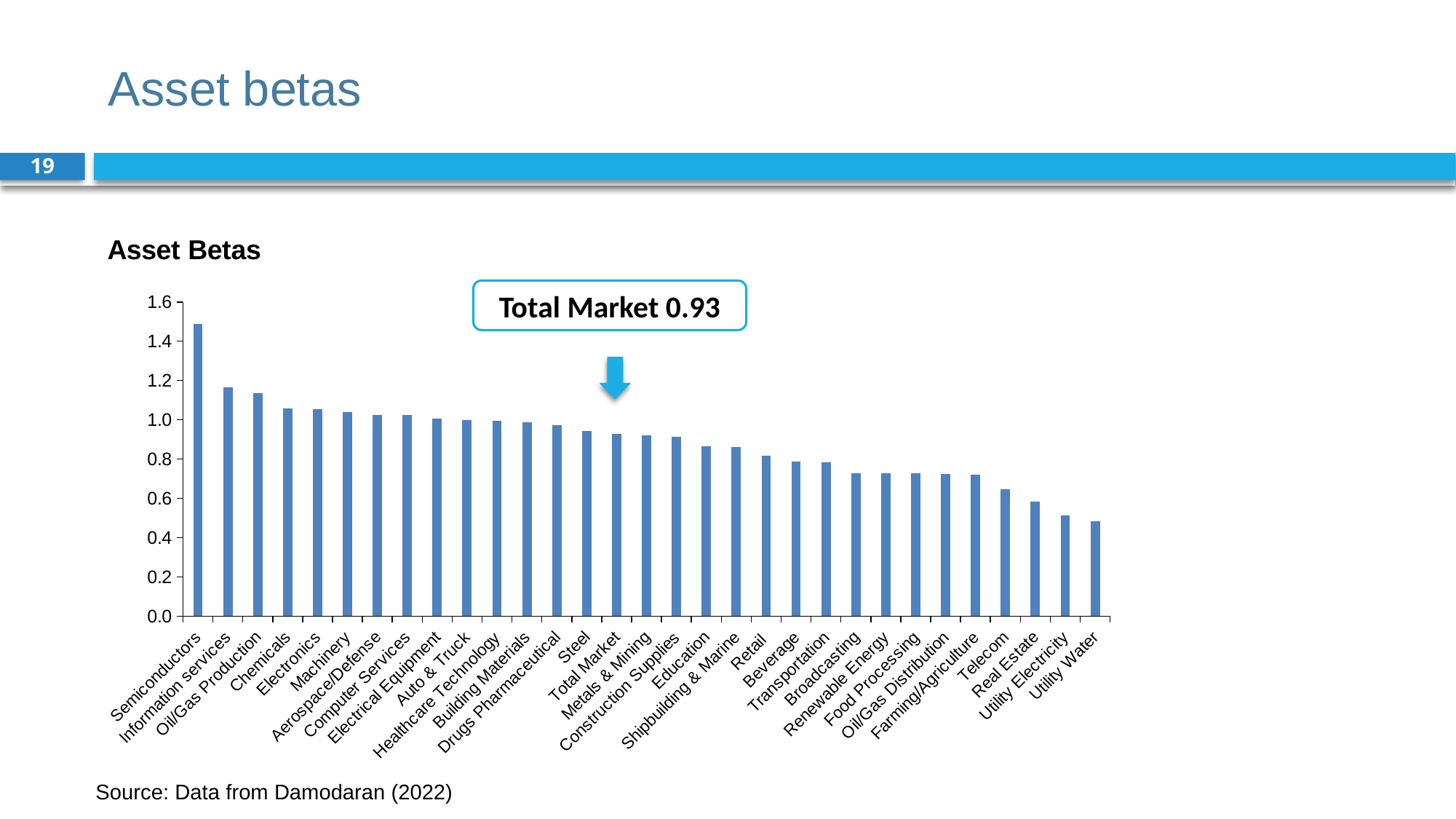
Is the asset beta for Utility Water greater or less than 0.6? less Is the asset beta for Telecom greater or less than 0.8? less Which category has the highest asset beta? Semiconductors How many categories are plotted in the chart? 31 What is the title of the chart? Asset Betas Do the asset betas rise or fall moving from left to right along the x axis? Fall What type of chart is shown on the slide? Bar chart Is the asset beta for Information services greater or less than 1.0? greater What is the asset beta for Total Market according to the callout on the chart? 0.93 Which category has the lowest asset beta? Utility Water Which has a higher asset beta, Information services or Telecom? Information services